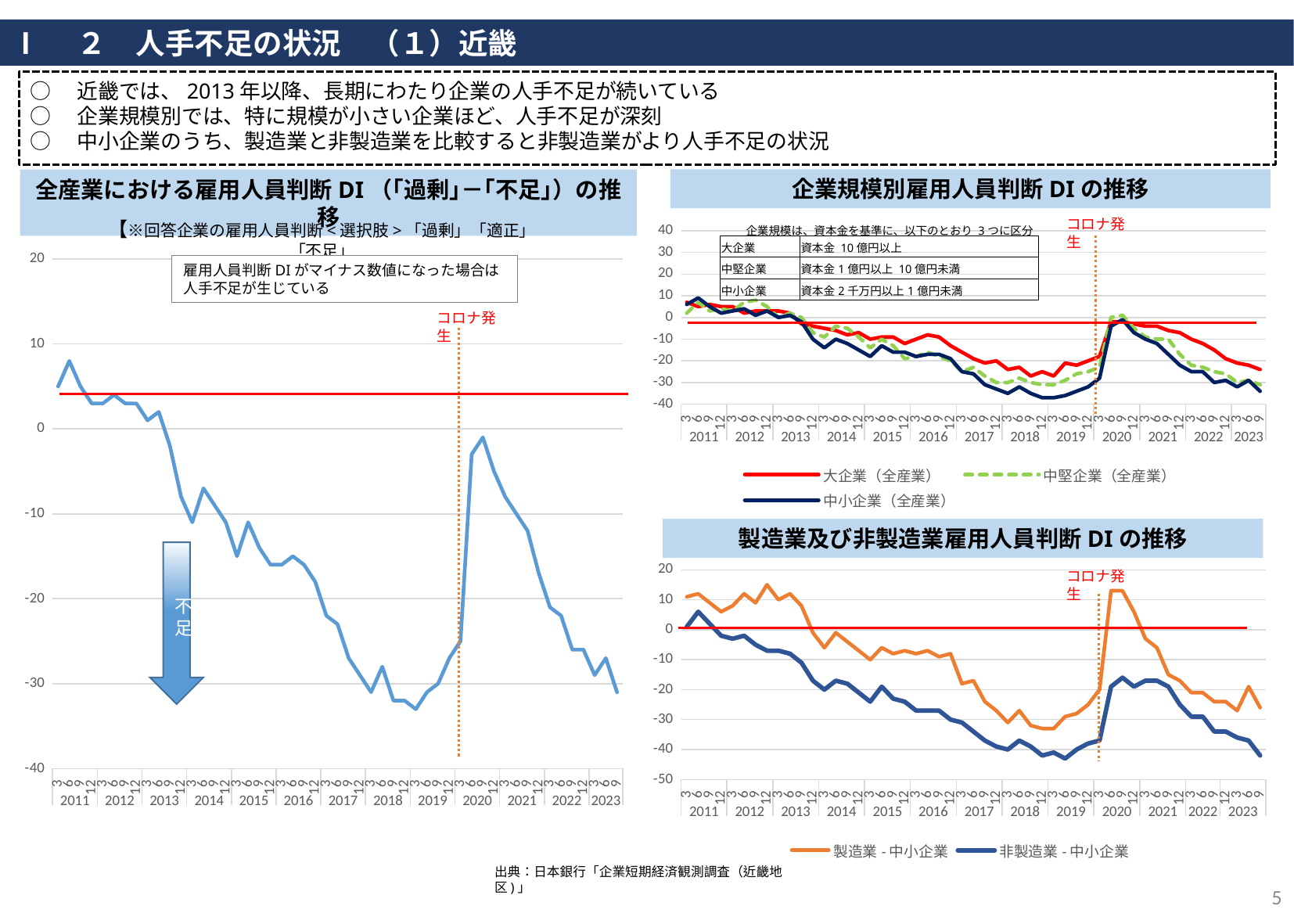
In the bottom-right chart (製造業及び非製造業雇用人員判断DIの推移), is the value for 非製造業-中小企業 at the end of 2023 greater or less than -30? less In the top-right chart (企業規模別雇用人員判断DIの推移), is the value for 中小企業（全産業） in 2018 greater or less than -30? less How many series does the legend list in the top-right chart 「企業規模別雇用人員判断DIの推移」? 3 In the left chart (全産業における雇用人員判断DI), does the line generally rise or fall from 2013 to 2019? fall What kind of chart is the left chart titled 「全産業における雇用人員判断DI（「過剰」－「不足」）の推移」? line chart In the top-right chart (企業規模別雇用人員判断DIの推移), which series is drawn as a dashed line? 中堅企業（全産業） How many years are labelled on the x axis of the left chart (全産業における雇用人員判断DI)? 13 In the top-right chart (企業規模別雇用人員判断DIの推移), which is larger at the end of 2023, 大企業（全産業） or 中小企業（全産業）? 大企業（全産業） In the left chart (全産業における雇用人員判断DI), is the value at the 2020 peak after コロナ発生 greater or less than -10? greater In the bottom-right chart (製造業及び非製造業雇用人員判断DIの推移), which is larger at the end of 2023, 製造業-中小企業 or 非製造業-中小企業? 製造業-中小企業 How many series does the legend list in the bottom-right chart 「製造業及び非製造業雇用人員判断DIの推移」? 2